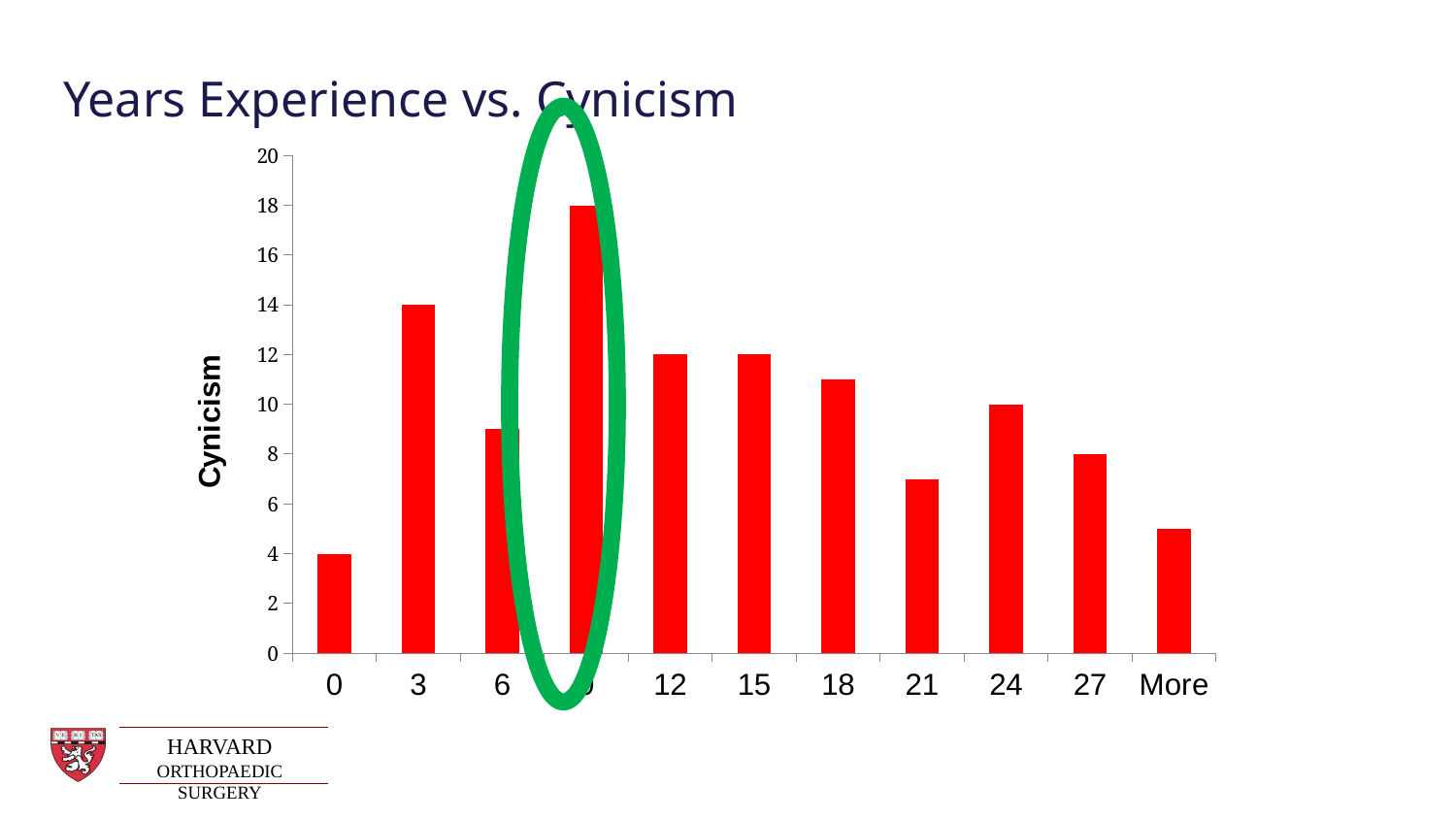
What type of chart is shown on the slide? bar chart Do the Cynicism values rise or fall from category 12 to category 21? fall How many bars (categories) are plotted on the x axis? 11 What is the difference between the Cynicism values for categories 3 and 0? 10 What is the Cynicism value for the category 12? 12 What is the Cynicism value for the category 24? 10 Is the Cynicism value for category 21 greater or less than 10? less Which has the higher Cynicism value, category 3 or category 12? 3 What is the Cynicism value for the category 0? 4 What is the title of the chart? Years Experience vs. Cynicism What is the Cynicism value for the category 3? 14 What is the label on the vertical axis? Cynicism